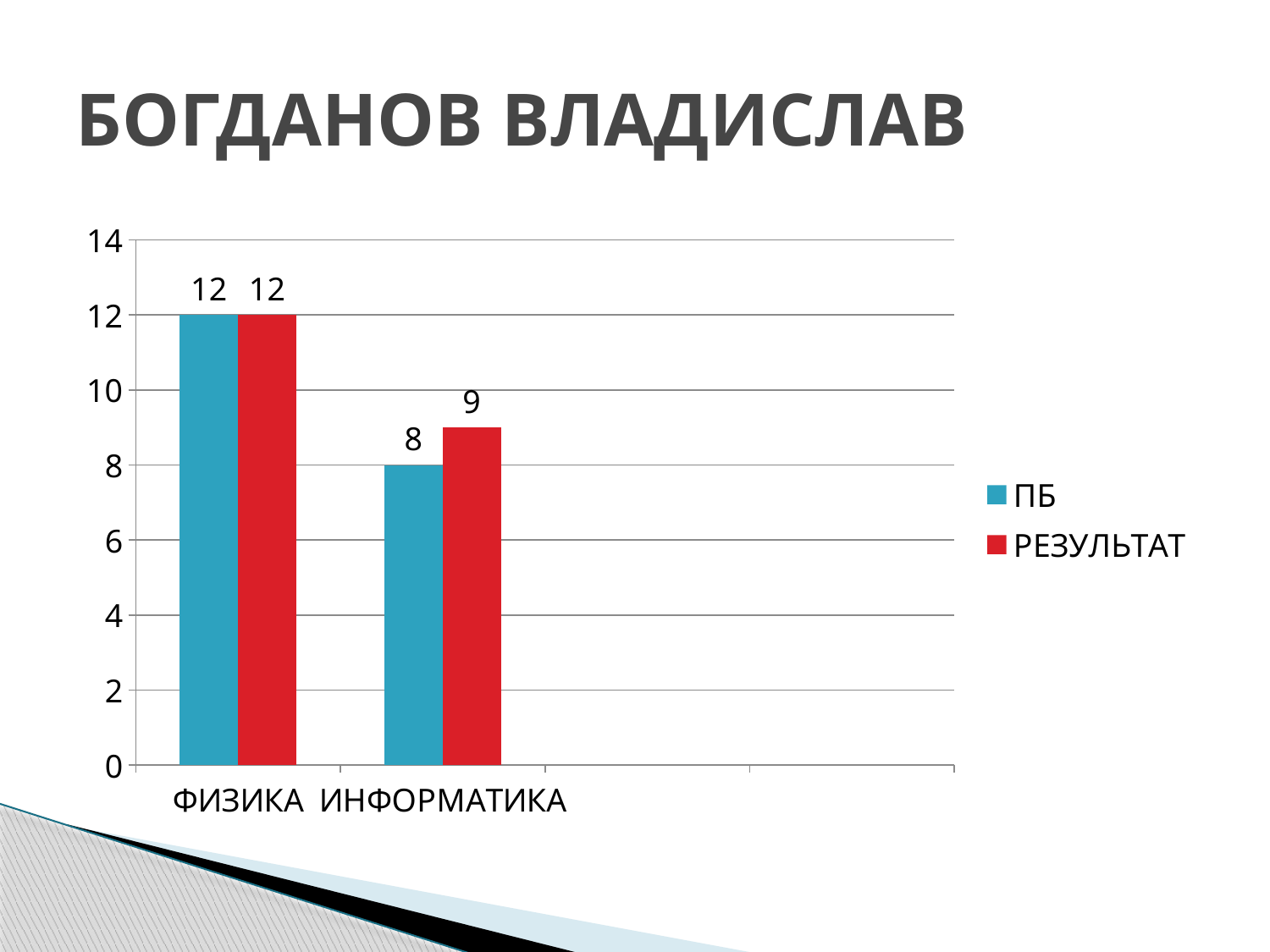
How many categories are shown on the x axis? 2 What is the difference between the ПБ values for ФИЗИКА and ИНФОРМАТИКА? 4 For ИНФОРМАТИКА, which is larger: ПБ or РЕЗУЛЬТАТ? РЕЗУЛЬТАТ What is the РЕЗУЛЬТАТ value for ИНФОРМАТИКА? 9 Which category has the lowest ПБ value? ИНФОРМАТИКА What is the ПБ value for ФИЗИКА? 12 How many series does the legend list? 2 Which category has the highest РЕЗУЛЬТАТ value? ФИЗИКА What is the ПБ value for ИНФОРМАТИКА? 8 What kind of chart is shown on the slide? bar chart What is the РЕЗУЛЬТАТ value for ФИЗИКА? 12 What is the difference between the РЕЗУЛЬТАТ and ПБ values for ИНФОРМАТИКА? 1